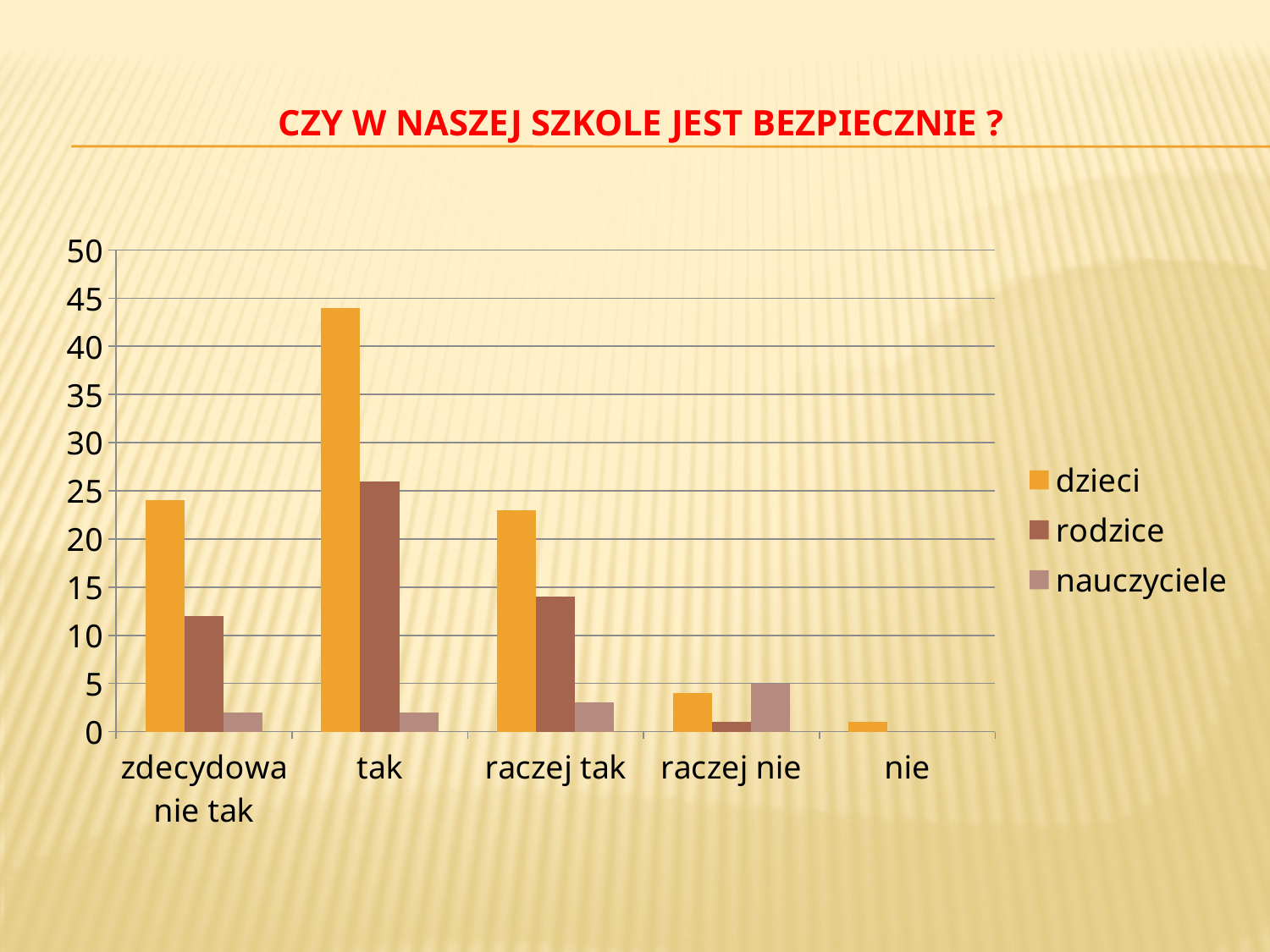
How many series does the legend list? 3 Which is larger in the category raczej nie: the value for dzieci or the value for nauczyciele? nauczyciele What kind of chart is shown on the slide? bar chart What is the title of the chart? CZY W NASZEJ SZKOLE JEST BEZPIECZNIE ? Is the value for rodzice in the category tak greater or less than 30? less Is the value for dzieci in the category tak greater or less than 40? greater Is the value for dzieci in the category zdecydowanie tak greater or less than 20? greater Which category has the highest value for rodzice? tak Which category has the highest value for dzieci? tak How many categories are shown on the x axis? 5 Which category has the lowest value for dzieci? nie Which is larger in the category raczej tak: the value for dzieci or the value for rodzice? dzieci